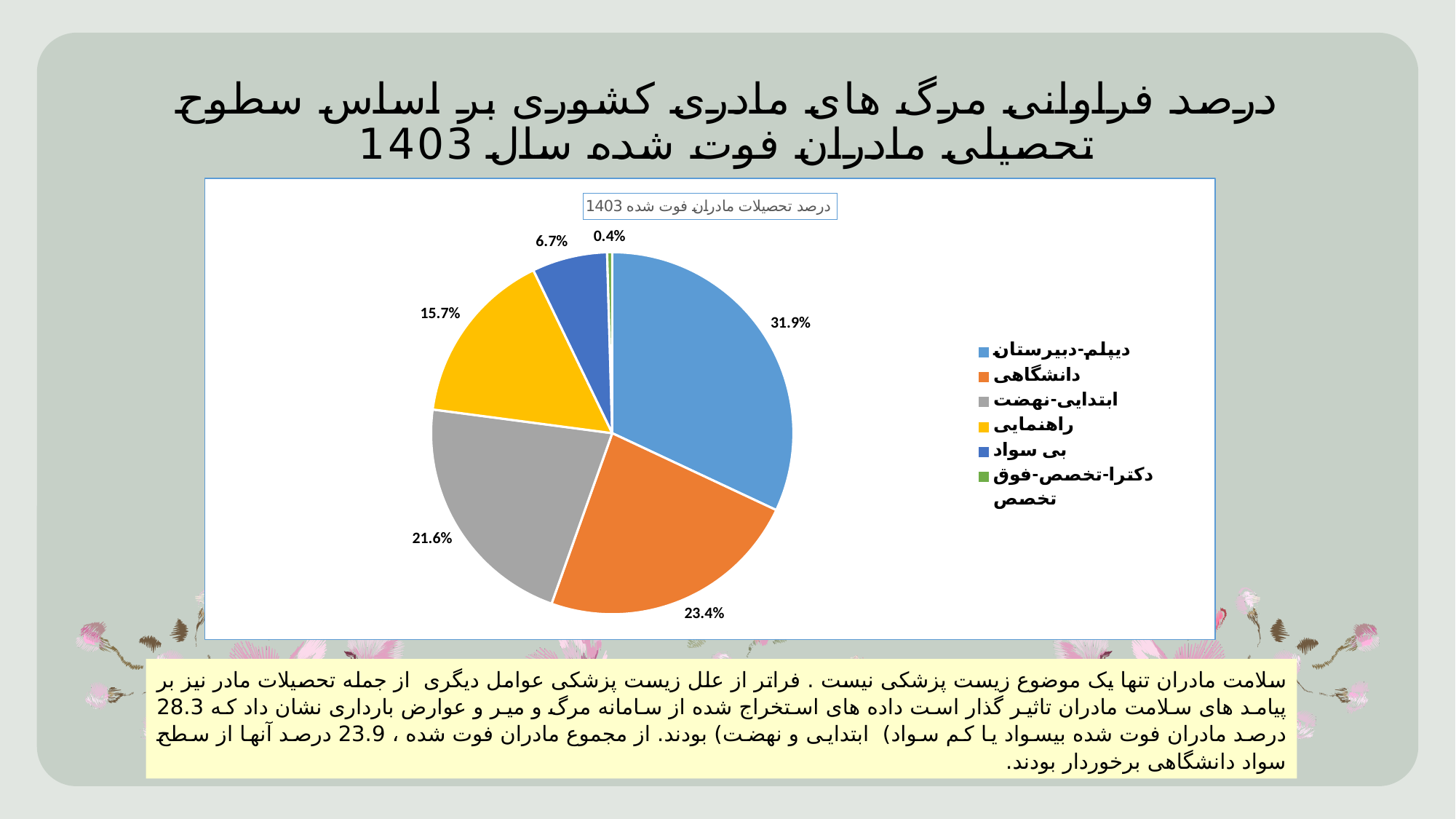
What is the share for دانشگاهی in the pie chart? 23.4% What is the share for راهنمایی in the pie chart? 15.7% Which category has the largest slice of the pie chart? دیپلم-دبیرستان What kind of chart is shown on the slide? pie chart What is the share for بی سواد in the pie chart? 6.7% What is the share for دیپلم-دبیرستان in the pie chart? 31.9% What is the difference between the shares for دیپلم-دبیرستان and دانشگاهی? 8.5% Which is larger, the share for ابتدایی-نهضت or the share for راهنمایی? ابتدایی-نهضت What is the share for ابتدایی-نهضت in the pie chart? 21.6% What colour is the slice for راهنمایی in the pie chart? yellow How many categories does the legend of the pie chart list? 6 Which category has the smallest slice of the pie chart? دکترا-تخصص-فوق تخصص